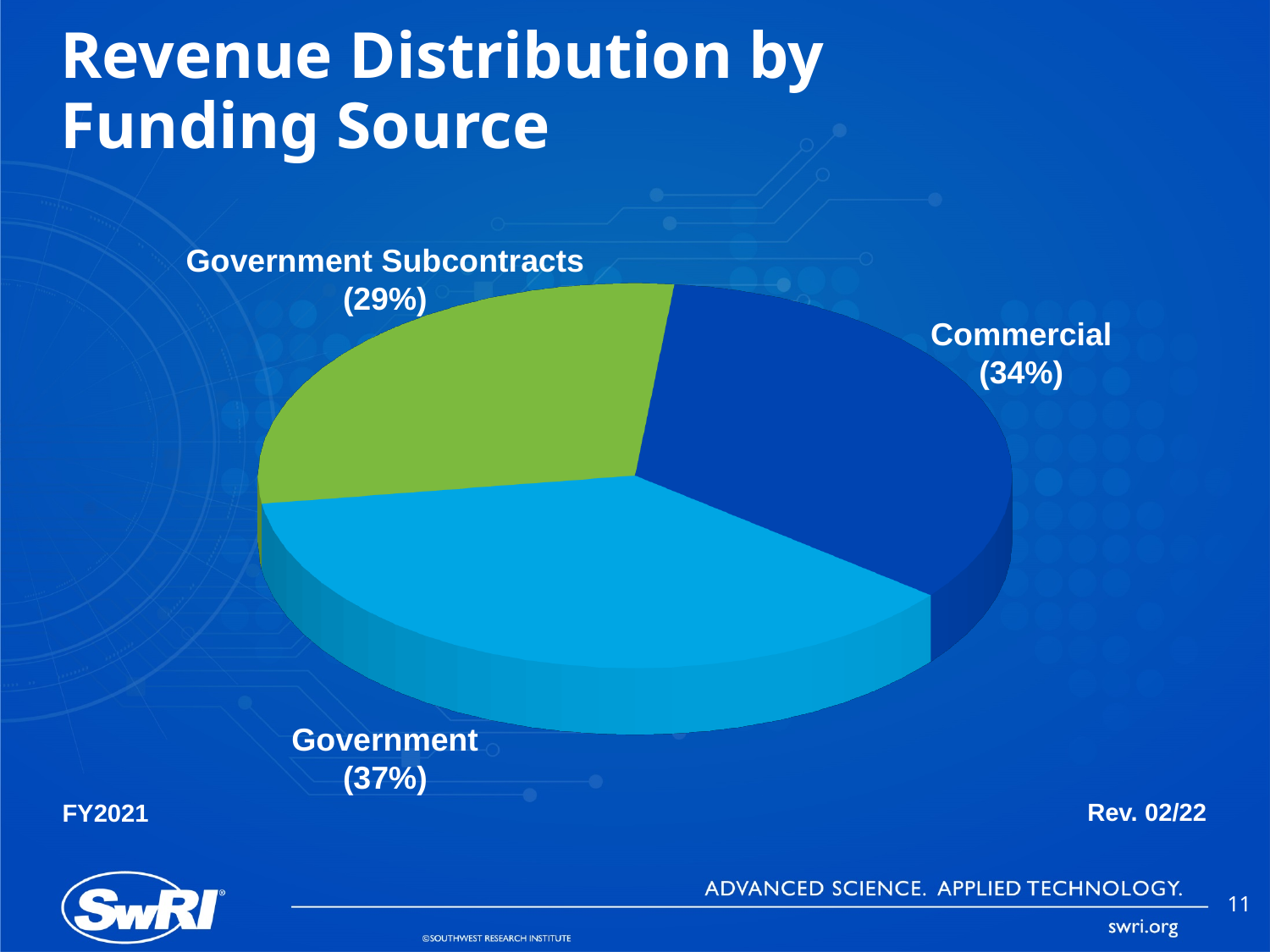
Which funding source has the smallest share of revenue? Government Subcontracts What is the title of the chart on the slide? Revenue Distribution by Funding Source What share of revenue comes from Government Subcontracts? 29% What is the difference in percentage points between the Government and Commercial shares? 3 Which fiscal year does the chart cover? FY2021 What is the difference in percentage points between the Commercial and Government Subcontracts shares? 5 How many funding sources are shown in the pie chart? 3 What share of revenue comes from Government funding? 37% Which funding source has the largest share of revenue? Government What kind of chart is shown on the slide? pie chart Which is larger, the Commercial share or the Government Subcontracts share? Commercial What share of revenue comes from Commercial funding? 34%